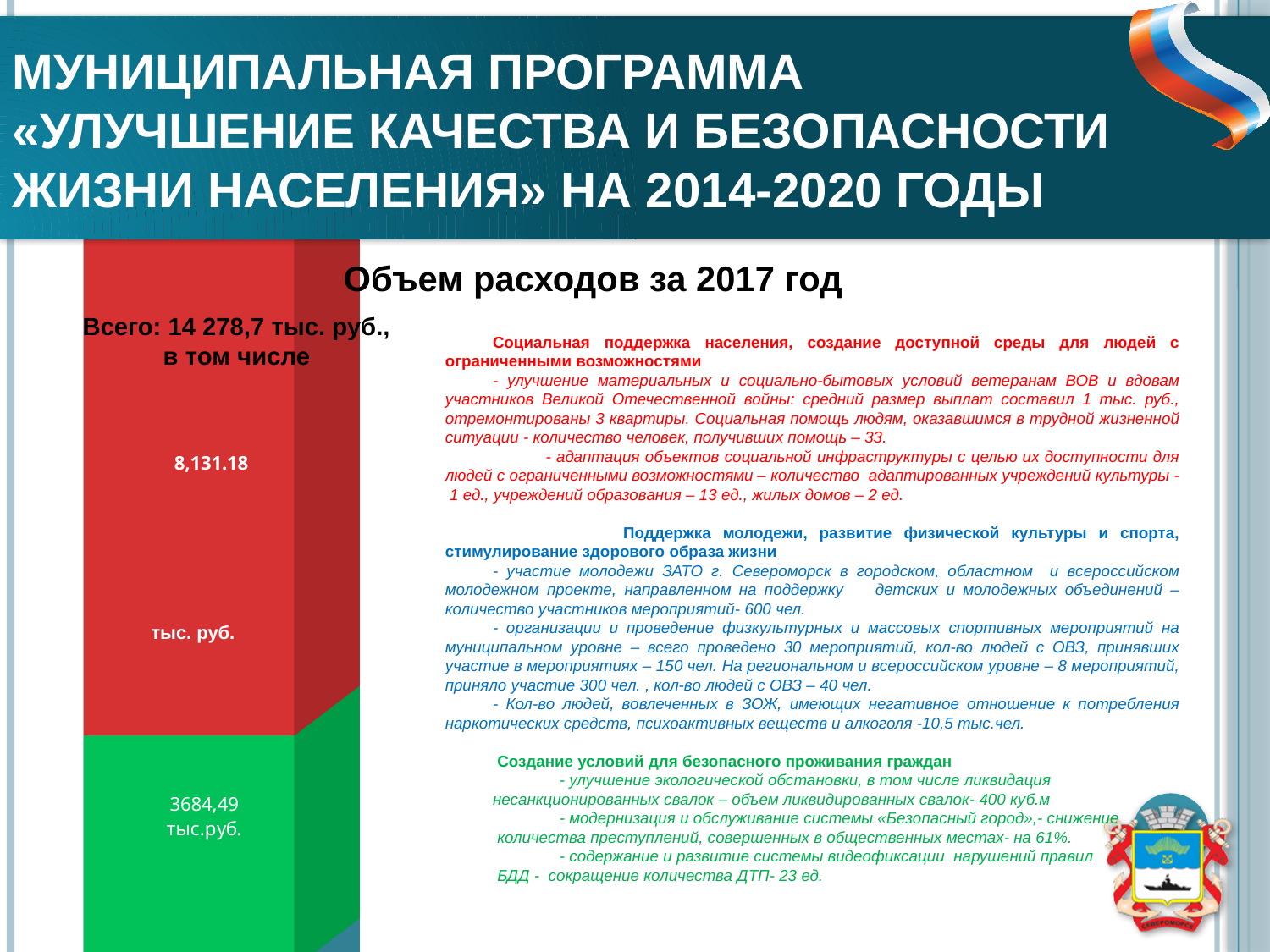
Is the value of the red segment greater or less than 8,000? greater Is the value of the green segment greater or less than 4,000? less Which segment is larger, the red one or the green one? the red one What value is printed on the green segment of the bar? 3684,49 тыс.руб. What colour is the largest segment of the bar? red What is the title shown above the chart? Объем расходов за 2017 год What kind of chart is shown on the slide? bar chart What value is printed on the red segment of the bar? 8,131.18 In what unit are the values on the bar expressed? тыс. руб. What total amount is stated for the stacked bar (Всего)? 14 278,7 тыс. руб.